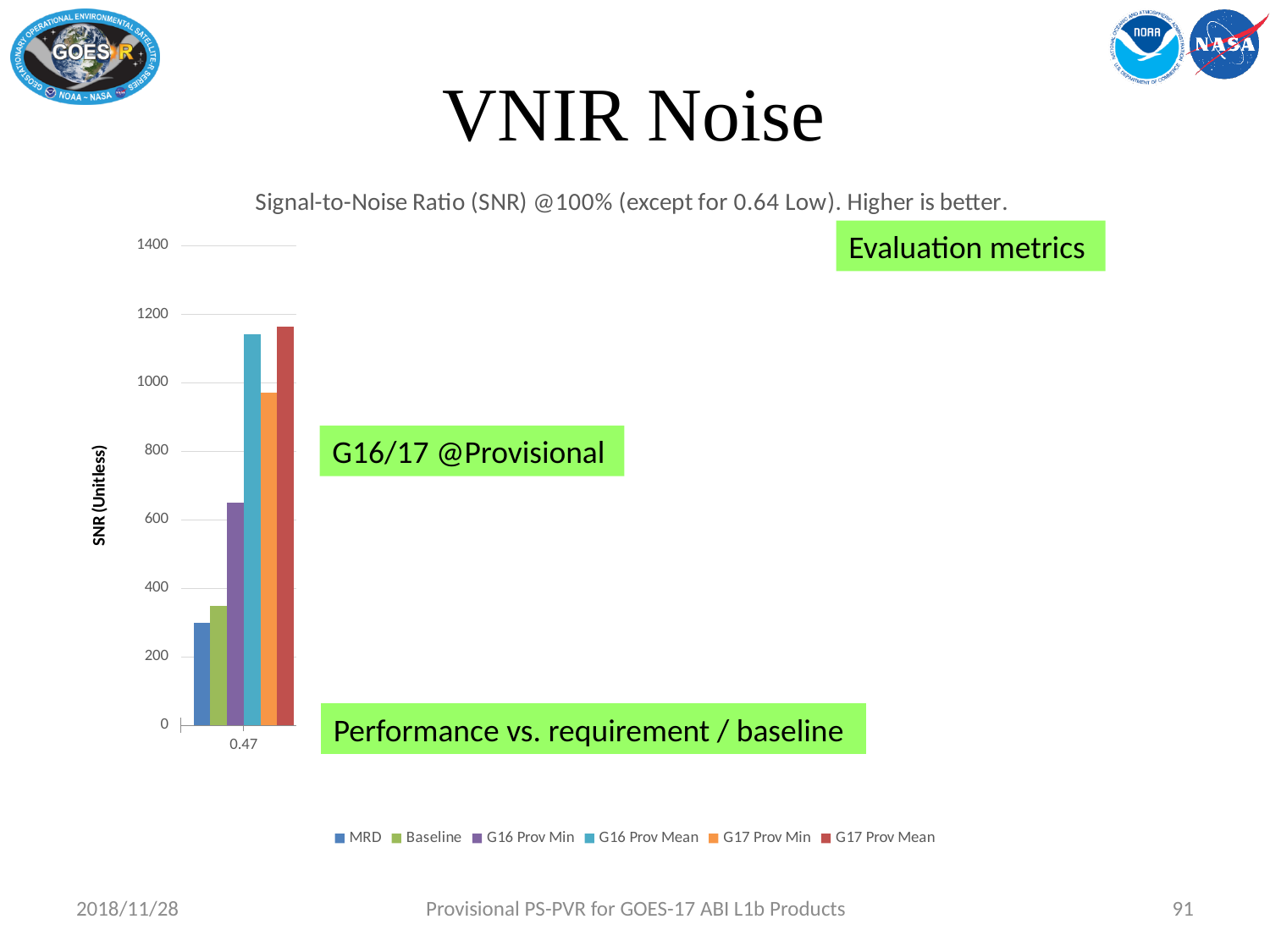
Is the value for Baseline greater or less than 400? less How many categories are shown on the x axis? 1 How many series does the legend list? 6 Is the value for G16 Prov Min greater or less than 600? greater Is the value for MRD greater or less than 400? less What is the category label on the x axis? 0.47 What is the title of the chart? Signal-to-Noise Ratio (SNR) @100% (except for 0.64 Low). Higher is better. What kind of chart is shown on the slide? bar chart Which is larger, the value for G16 Prov Mean or the value for G16 Prov Min? G16 Prov Mean Which is larger, the value for G16 Prov Min or the value for G17 Prov Min? G17 Prov Min